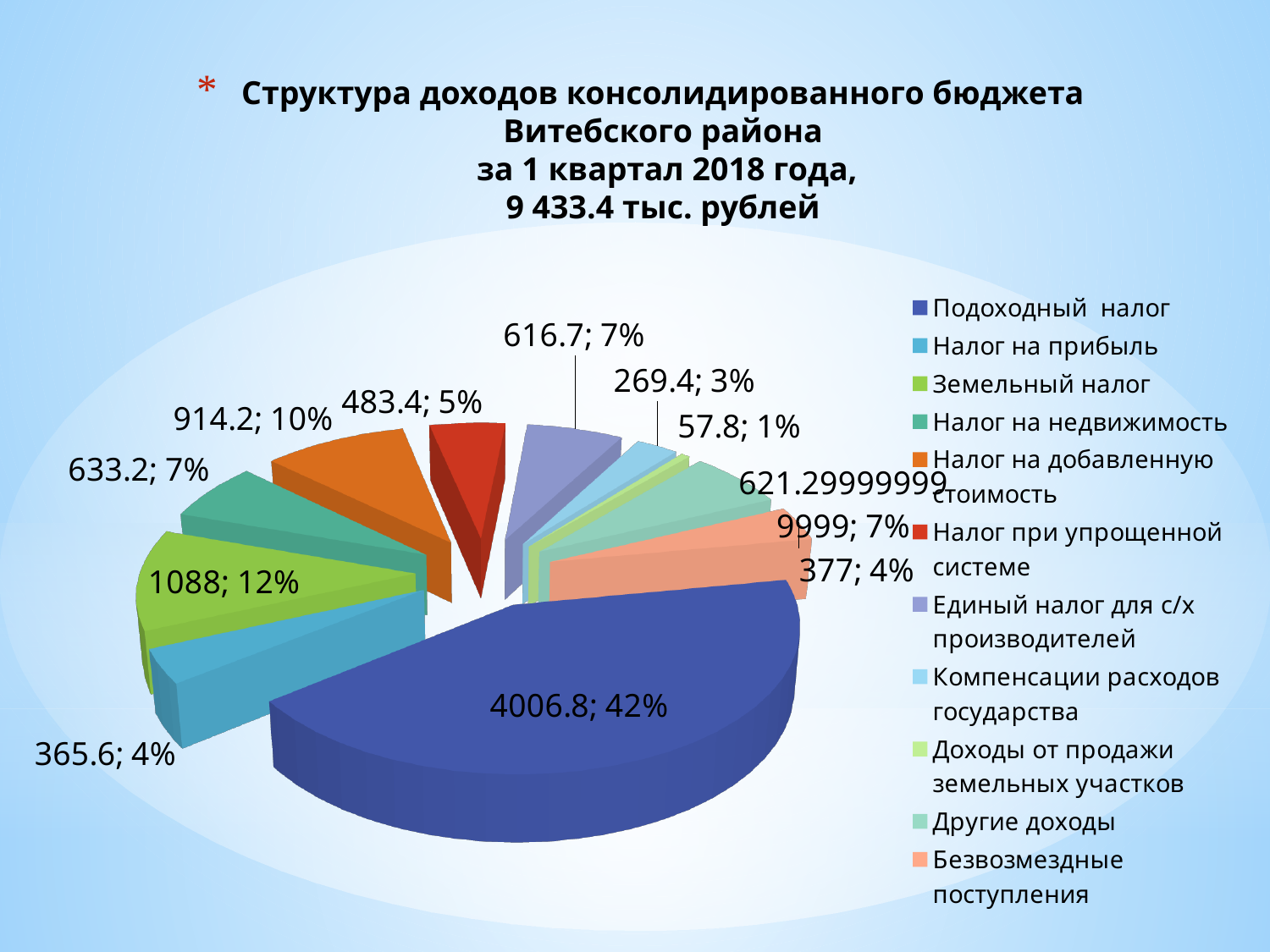
What value is shown for Земельный налог? 1088 What total amount is stated in the chart title? 9 433.4 тыс. рублей Which is larger, the value for Налог на недвижимость or the value for Налог при упрощенной системе? Налог на недвижимость What kind of chart is shown on the slide? pie chart What value is shown for Безвозмездные поступления? 377 What value is shown for Подоходный налог? 4006.8 Which category has the largest slice of the pie? Подоходный налог How many categories does the legend of the pie chart list? 11 Which category has the smallest slice of the pie? Доходы от продажи земельных участков What is the difference between the values for Земельный налог and Налог на прибыль? 722.4 What share of the pie does Налог на добавленную стоимость represent? 10% What share of the pie does Подоходный налог represent? 42%